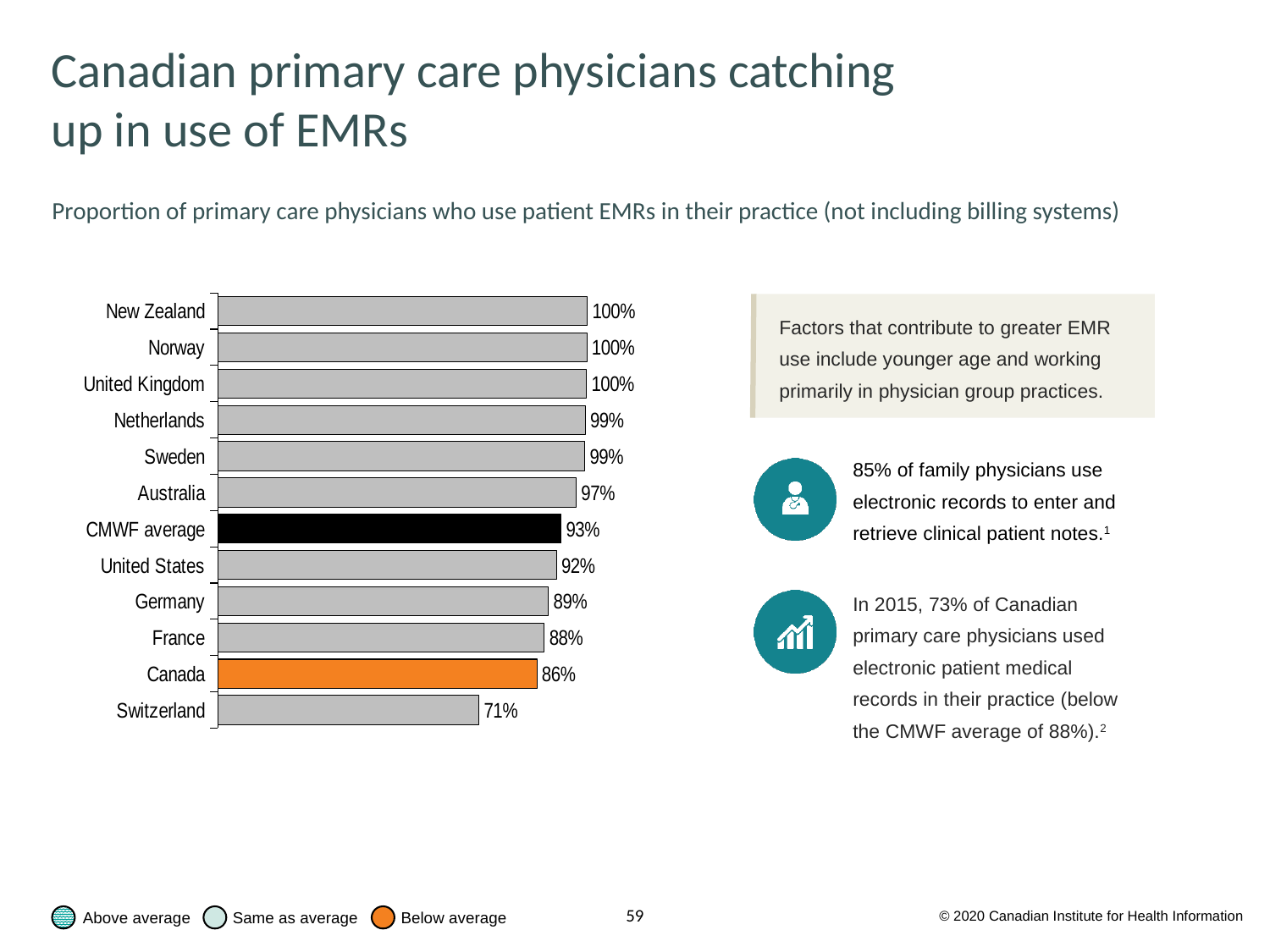
How many categories are shown in the chart? 12 What is the difference between Canada and Switzerland? 15% What is the value for Switzerland? 71% What is the value for the CMWF average? 93% What is the difference between the CMWF average and Canada? 7% Which is larger, the value for Germany or the value for France? Germany What kind of chart is shown on the slide? Bar chart What is the value for Australia? 97% Which is larger, the value for the United States or the value for Canada? United States Which category has the lowest value? Switzerland What is the value for Canada? 86% What colour is the bar for Canada? Orange